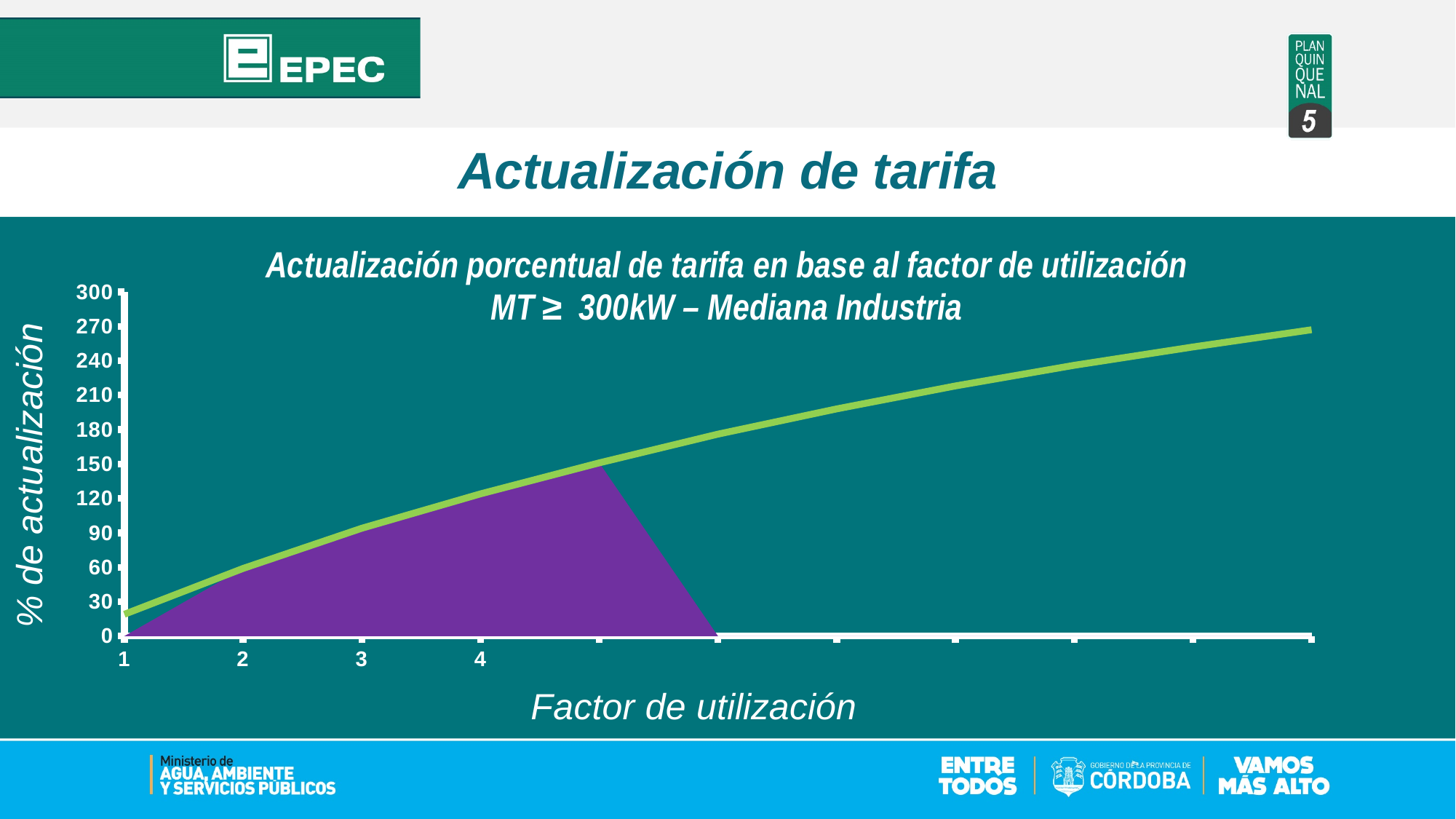
Is the value for factor de utilización 4 greater or less than 90? greater Is the highest value reached by the line greater or less than 240? greater Is the value for factor de utilización 3 greater or less than 60? greater What is the highest tick value shown on the y axis? 300 Which factor de utilización value shown on the x axis has the lowest % de actualización? 1 What is the title of the x axis? Factor de utilización Do the values on the chart rise or fall as the factor de utilización increases? rise What kind of chart is shown on the slide? line chart with a shaded area (combination line and area chart)